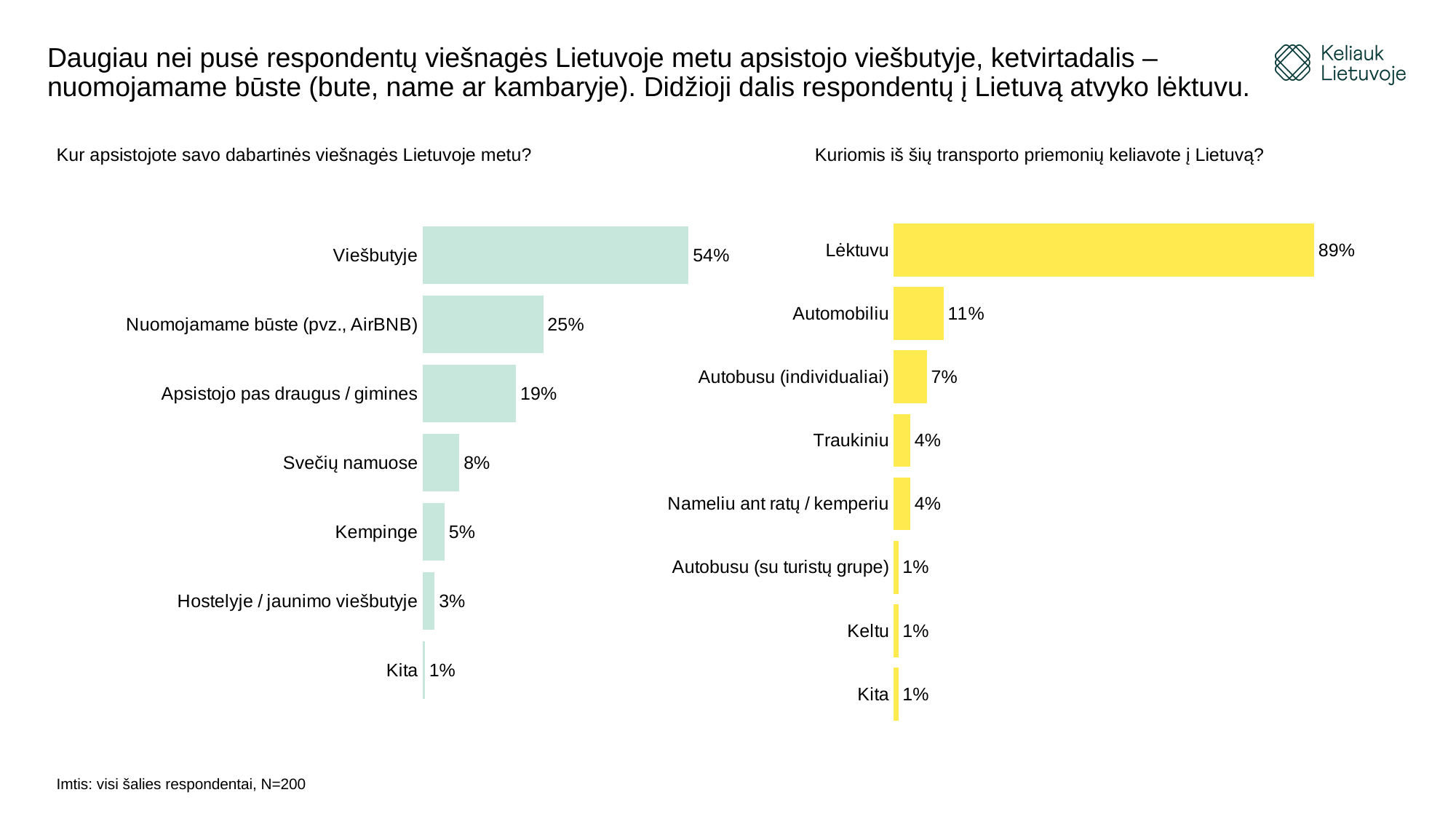
In the right chart (Kuriomis iš šių transporto priemonių keliavote į Lietuvą?), which is larger: Autobusu (individualiai) or Traukiniu? Autobusu (individualiai) In the left chart (Kur apsistojote savo dabartinės viešnagės Lietuvoje metu?), which is larger: Kempinge or Hostelyje / jaunimo viešbutyje? Kempinge In the right chart (Kuriomis iš šių transporto priemonių keliavote į Lietuvą?), which category has the highest value? Lėktuvu In the left chart (Kur apsistojote savo dabartinės viešnagės Lietuvoje metu?), what is the value for Viešbutyje? 54% In the right chart (Kuriomis iš šių transporto priemonių keliavote į Lietuvą?), what is the value for Automobiliu? 11% How many categories are shown in the left chart (Kur apsistojote savo dabartinės viešnagės Lietuvoje metu?)? 7 In the left chart (Kur apsistojote savo dabartinės viešnagės Lietuvoje metu?), what is the value for Svečių namuose? 8% How many categories are shown in the right chart (Kuriomis iš šių transporto priemonių keliavote į Lietuvą?)? 8 In the left chart (Kur apsistojote savo dabartinės viešnagės Lietuvoje metu?), what is the difference between Viešbutyje and Nuomojamame būste (pvz., AirBNB)? 29% In the left chart (Kur apsistojote savo dabartinės viešnagės Lietuvoje metu?), which category has the lowest value? Kita In the right chart (Kuriomis iš šių transporto priemonių keliavote į Lietuvą?), what is the difference between Lėktuvu and Automobiliu? 78% What type of chart is the right chart (Kuriomis iš šių transporto priemonių keliavote į Lietuvą?)? Bar chart